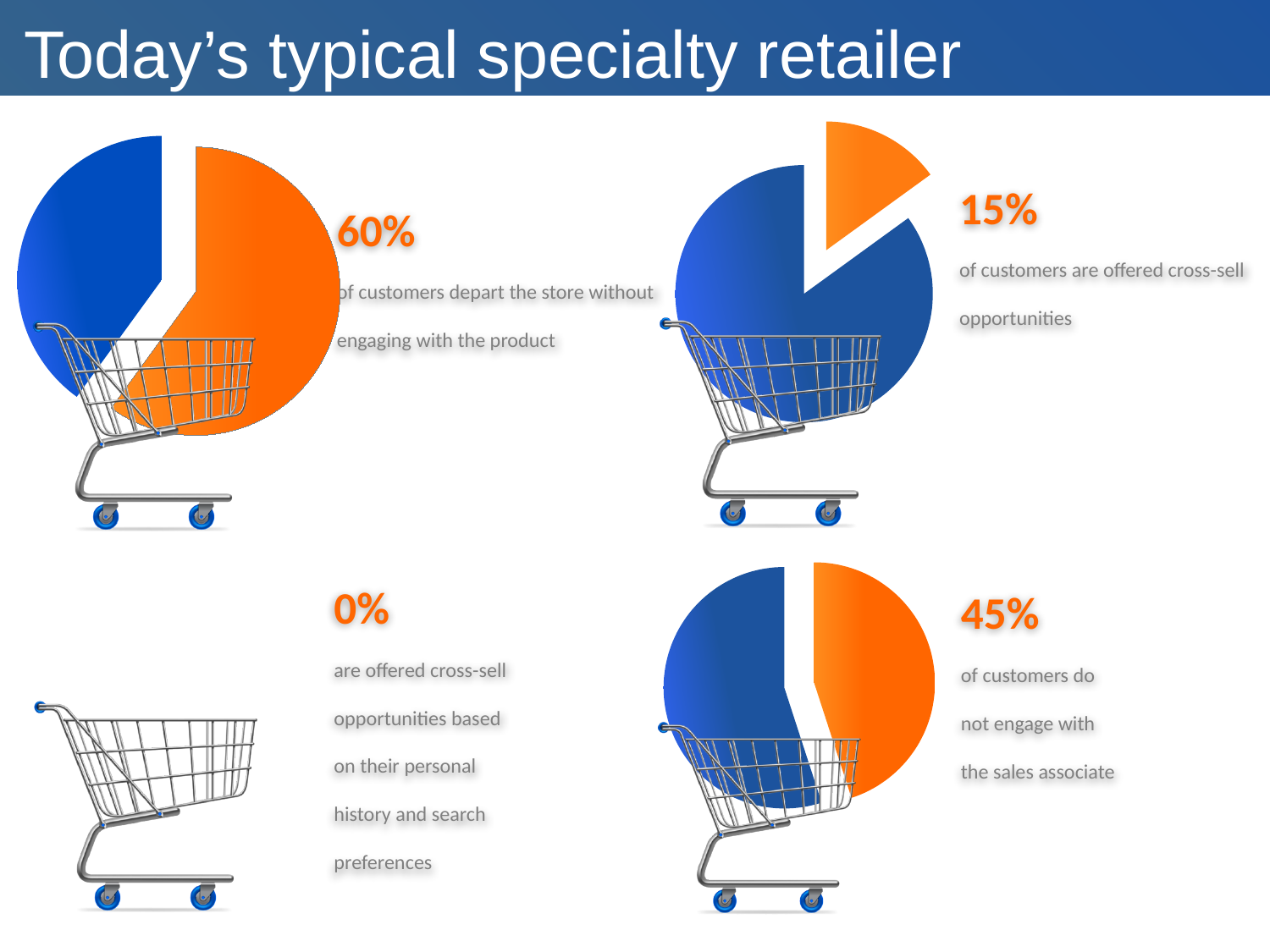
What kind of charts are shown on the slide? Pie charts Which of the three pie charts shows the smallest highlighted (orange) share? The top-right pie chart (15%) Which of the three pie charts shows the largest highlighted (orange) share? The top-left pie chart (60%) In the bottom-right pie chart, what share of customers do not engage with the sales associate? 45% Which is larger: the share of customers who depart without engaging with the product (top-left) or the share who do not engage with the sales associate (bottom-right)? Customers who depart without engaging with the product (60%) In the top-right pie chart, what share of customers are offered cross-sell opportunities? 15% How many pie charts are shown on the slide? 3 What is the difference between the 45% share in the bottom-right pie chart and the 15% share in the top-right pie chart? 30 percentage points What colour is used for the highlighted slice in each pie chart? Orange What percentage is shown for customers offered cross-sell opportunities based on their personal history and search preferences (bottom-left)? 0% What is the difference between the 60% share in the top-left pie chart and the 15% share in the top-right pie chart? 45 percentage points In the top-left pie chart, what share of customers depart the store without engaging with the product? 60%